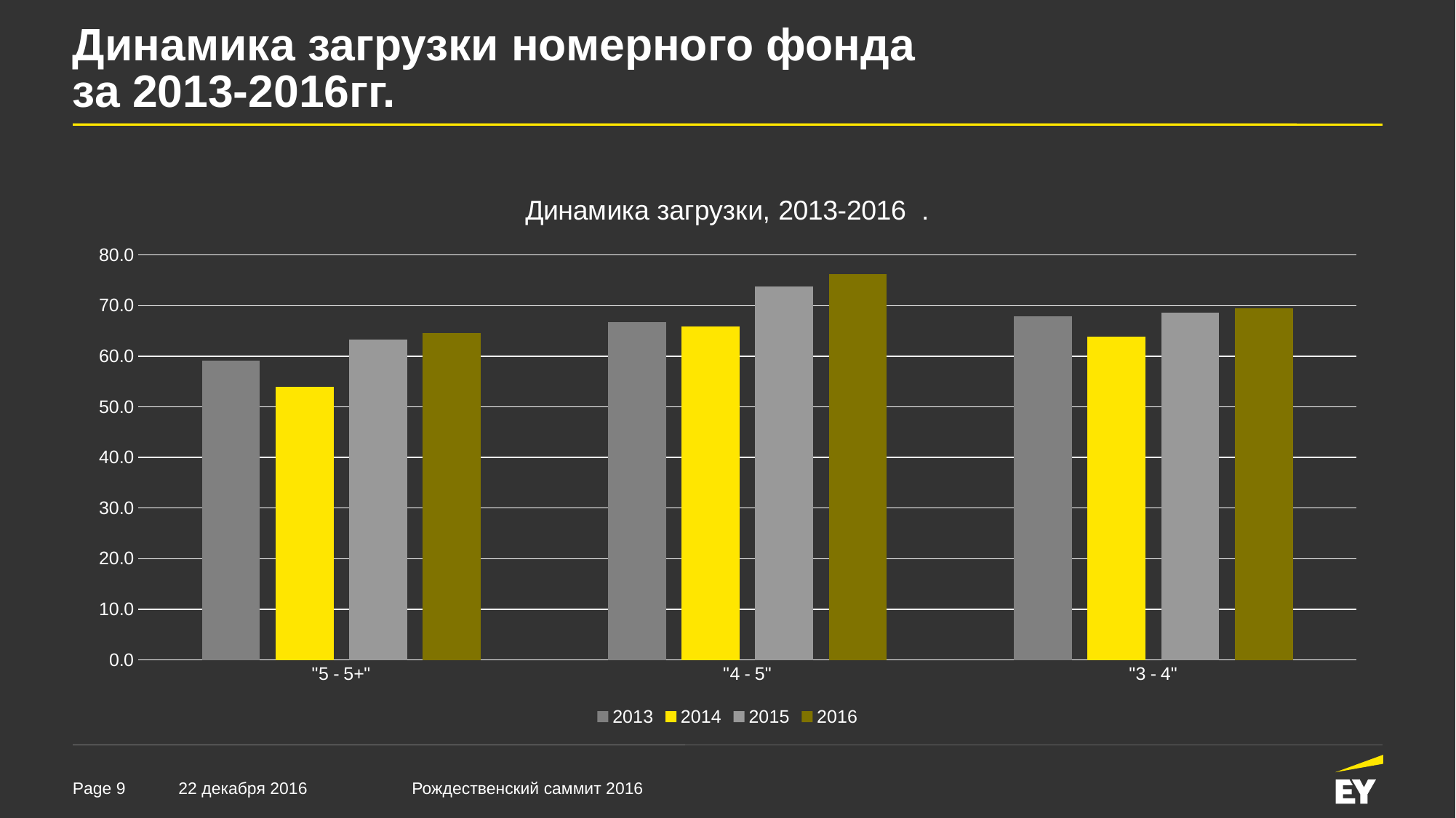
In the "5 - 5+" category, which is larger: the 2013 value or the 2014 value? 2013 Is the value for 2016 in the "4 - 5" category greater or less than 70.0? greater What kind of chart is shown on the slide? bar chart In the "4 - 5" category, which is larger: the 2014 value or the 2015 value? 2015 In the "4 - 5" category, which year has the tallest bar? 2016 Is the value for 2014 in the "5 - 5+" category greater or less than 60.0? less Is the value for 2013 in the "3 - 4" category greater or less than 60.0? greater What is the title of the chart? Динамика загрузки, 2013-2016 . Which category has the lowest 2014 value? "5 - 5+" Which category has the highest 2016 value? "4 - 5" How many series does the legend list? 4 How many categories are shown on the x axis? 3